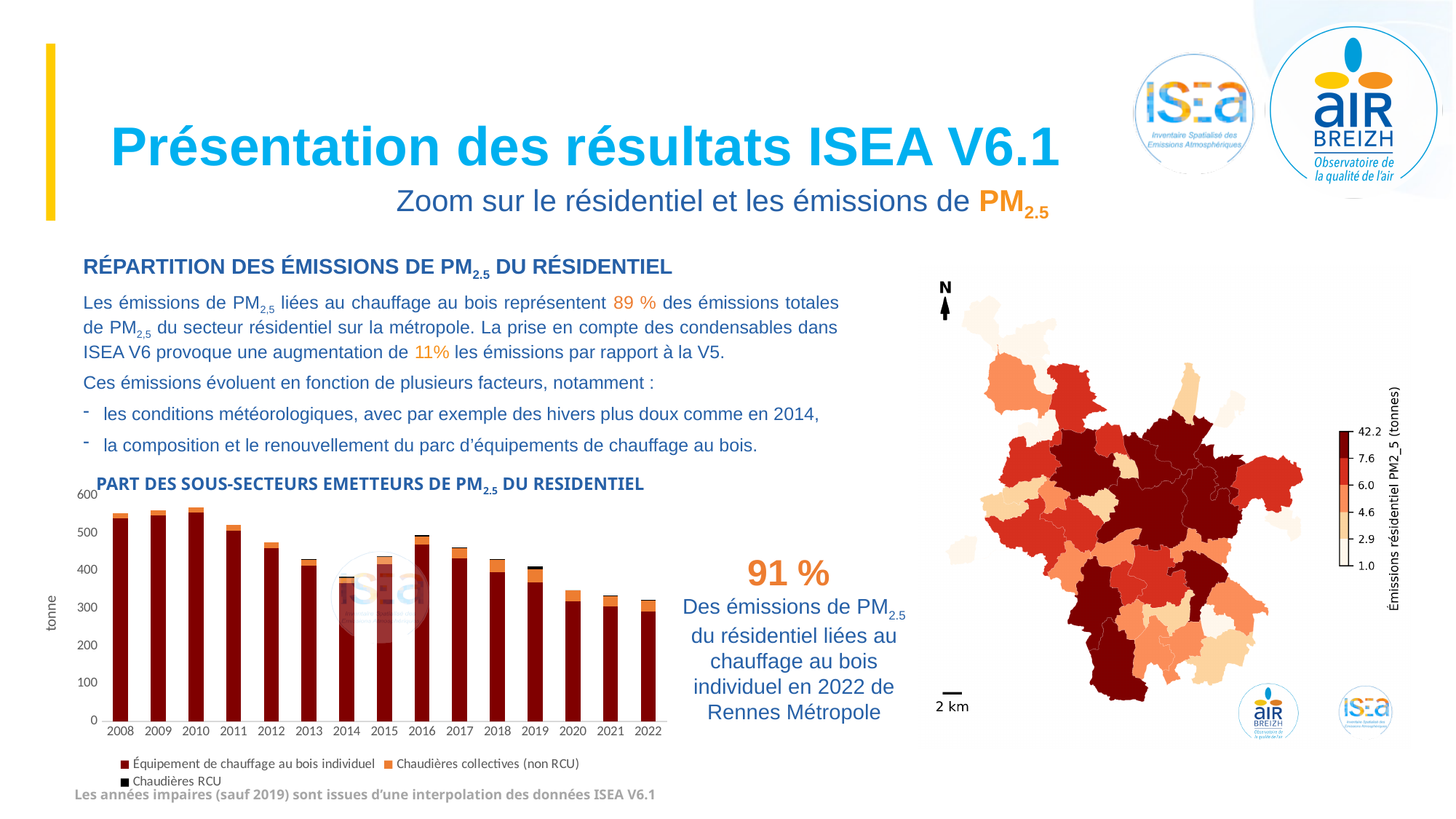
In the bar chart, is the total value for 2022 greater or less than 400? less How many series does the legend of the bar chart list? 3 What is the unit shown on the y axis of the bar chart? tonne In the bar chart, which year has the larger total, 2014 or 2016? 2016 Overall, do the total emissions in the bar chart rise or fall from 2008 to 2022? Fall Which series in the bar chart is shown in dark red? Équipement de chauffage au bois individuel How many years are shown on the x axis of the bar chart? 15 In the bar chart, which year has the larger total, 2008 or 2022? 2008 What kind of chart is 'PART DES SOUS-SECTEURS EMETTEURS DE PM2.5 DU RESIDENTIEL'? Stacked bar chart In the bar chart, is the total value for 2012 greater or less than 500? less In the bar chart, is the total value for 2014 greater or less than 400? less